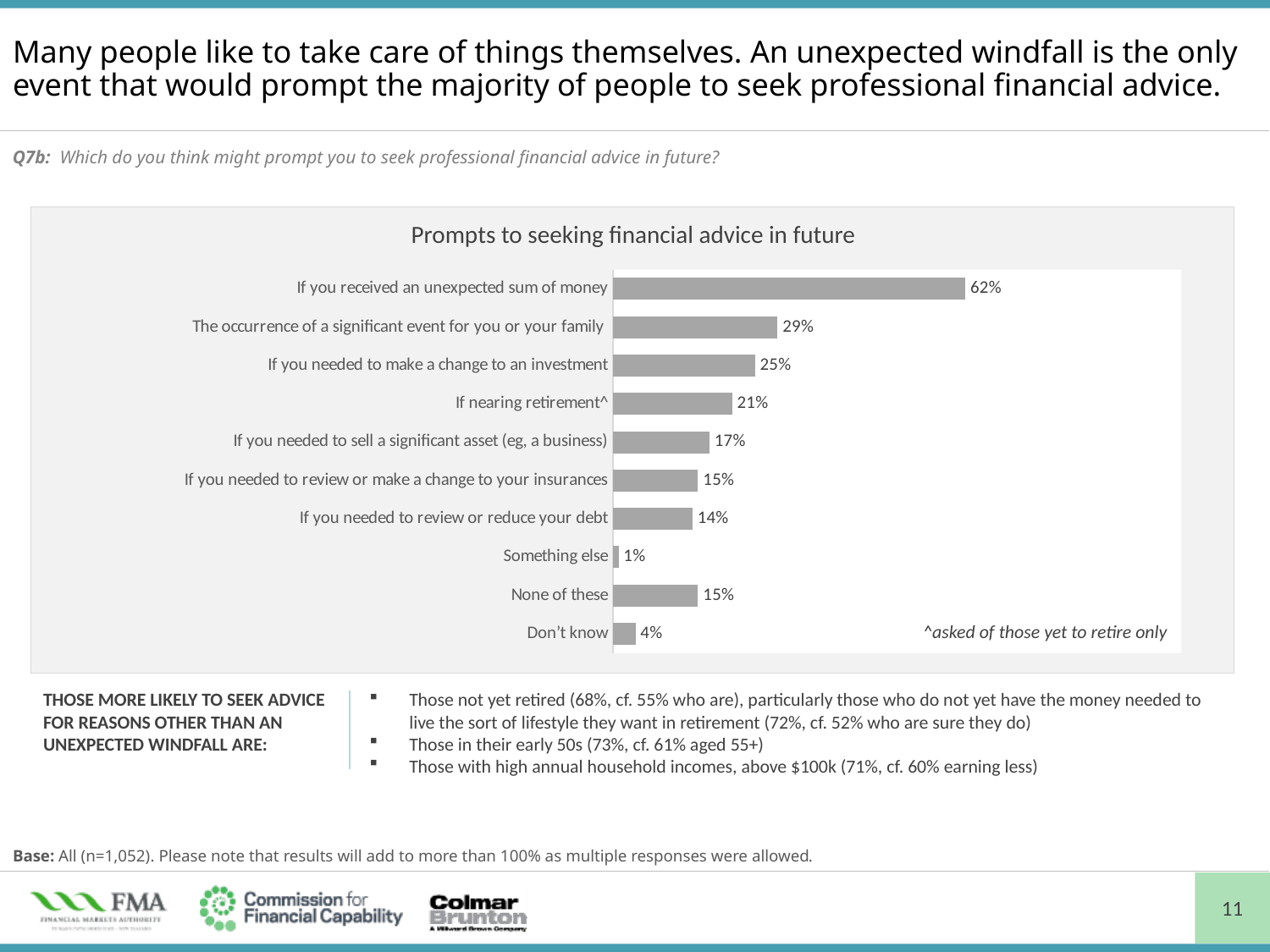
Which prompt has the highest percentage in the chart? If you received an unexpected sum of money What is the value for 'Don't know'? 4% What percentage said 'None of these'? 15% What is the value for 'If nearing retirement^'? 21% How many categories are shown in the chart? 10 What is the title of the chart? Prompts to seeking financial advice in future What type of chart is used to show the prompts to seeking financial advice? Bar chart Which is larger: the value for 'If you needed to make a change to an investment' or the value for 'If you needed to sell a significant asset (eg, a business)'? If you needed to make a change to an investment What percentage of respondents said receiving an unexpected sum of money might prompt them to seek professional financial advice? 62% Which category has the lowest percentage in the chart? Something else What is the difference in percentage points between 'If you needed to review or make a change to your insurances' and 'If you needed to review or reduce your debt'? 1 What is the difference in percentage points between 'If you received an unexpected sum of money' and 'The occurrence of a significant event for you or your family'? 33